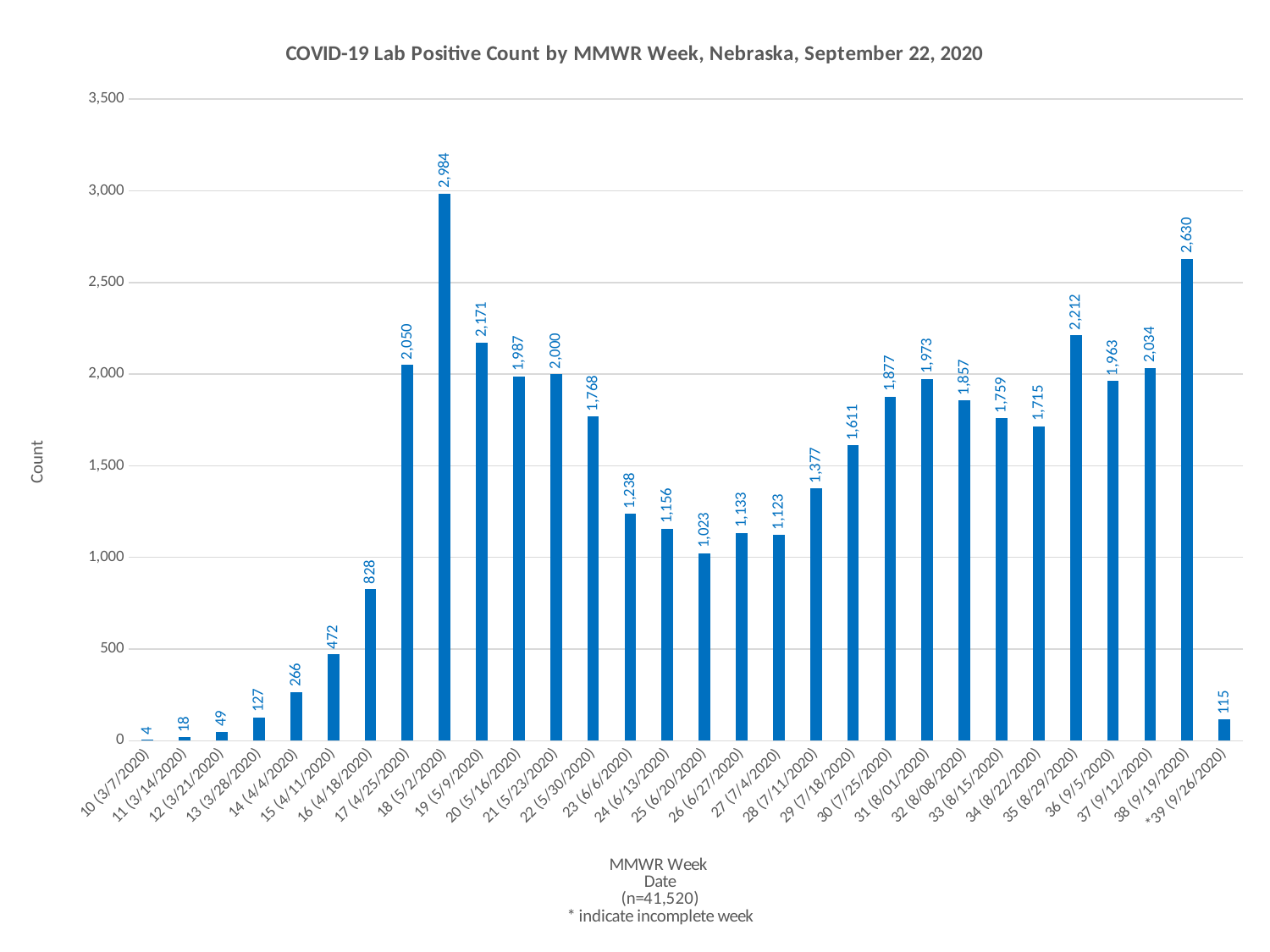
What is the lab positive count for MMWR week 38 (9/19/2020)? 2,630 What is the difference between the counts for week 18 (5/2/2020) and week 38 (9/19/2020)? 354 What is the difference between the counts for week 35 (8/29/2020) and week 36 (9/5/2020)? 249 Do the counts rise or fall from week 10 (3/7/2020) through week 18 (5/2/2020)? Rise Which MMWR week has the highest lab positive count? 18 (5/2/2020) What is the lab positive count for MMWR week 18 (5/2/2020)? 2,984 Which MMWR week has the lowest lab positive count? 10 (3/7/2020) What is the lab positive count for MMWR week 25 (6/20/2020)? 1,023 How many MMWR weeks are plotted on the chart? 30 Which has a higher count, week 17 (4/25/2020) or week 19 (5/9/2020)? 19 (5/9/2020) Is the count for week 16 (4/18/2020) greater or less than 1,000? less What type of chart is shown on the slide? Bar chart